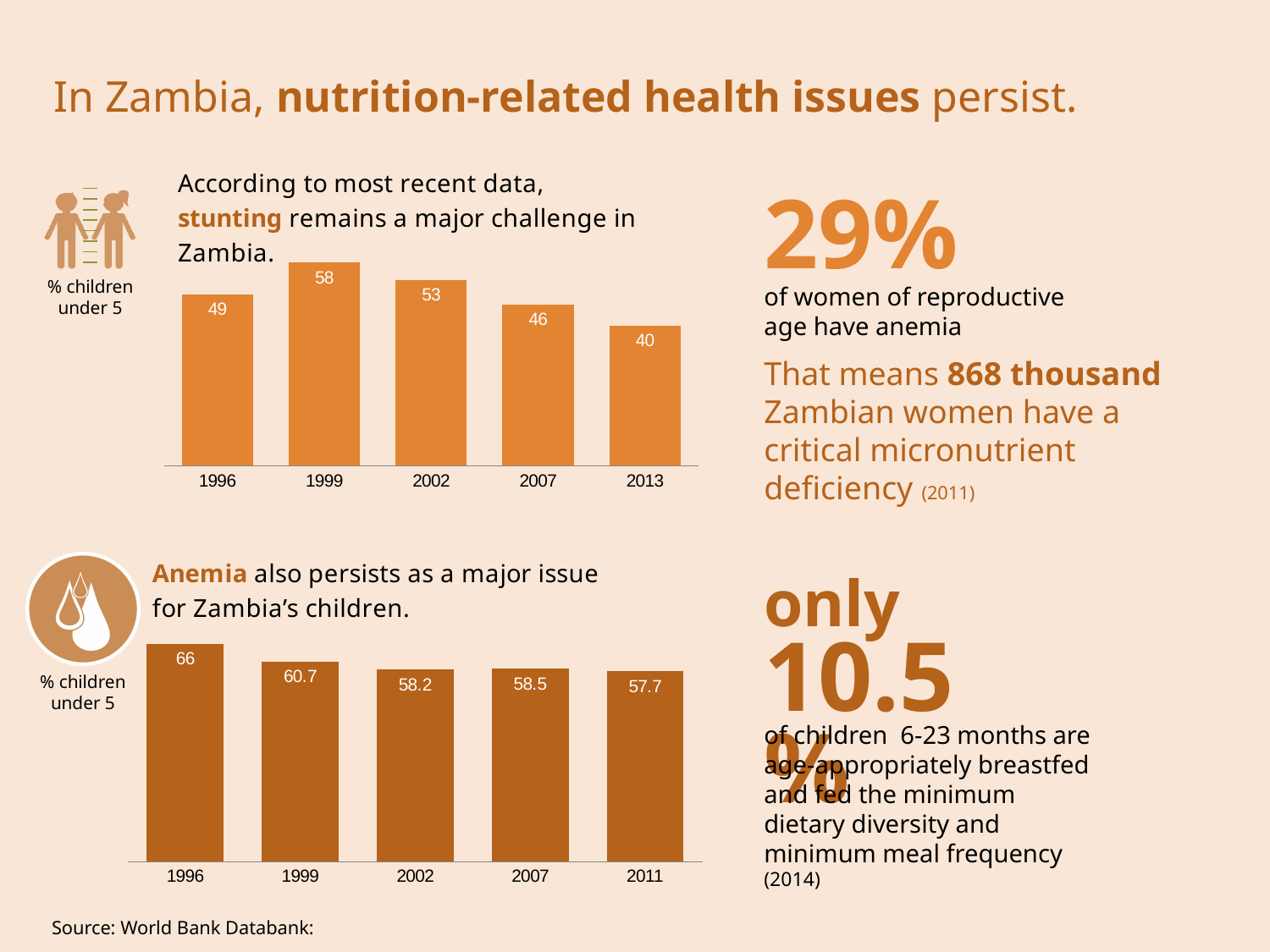
In the stunting chart (top), what is the difference between the 1996 and 2013 values? 9 In the anemia chart (bottom), what is the difference between the 1996 and 2011 values? 8.3 In the stunting chart (top), what is the value for 1999? 58 In the stunting chart (top), what is the value for 2007? 46 In the stunting chart (top), which year has the lowest value? 2013 In the anemia chart (bottom), what is the value for 2002? 58.2 What kind of chart is the stunting chart (top)? bar chart In the stunting chart (top), which year has the highest value? 1999 In the stunting chart (top), how many years are plotted? 5 In the anemia chart (bottom), which year has the highest value? 1996 In the anemia chart (bottom), do the values generally rise or fall from 1996 to 2011? fall In the anemia chart (bottom), which is larger, the value for 1999 or the value for 2011? 1999